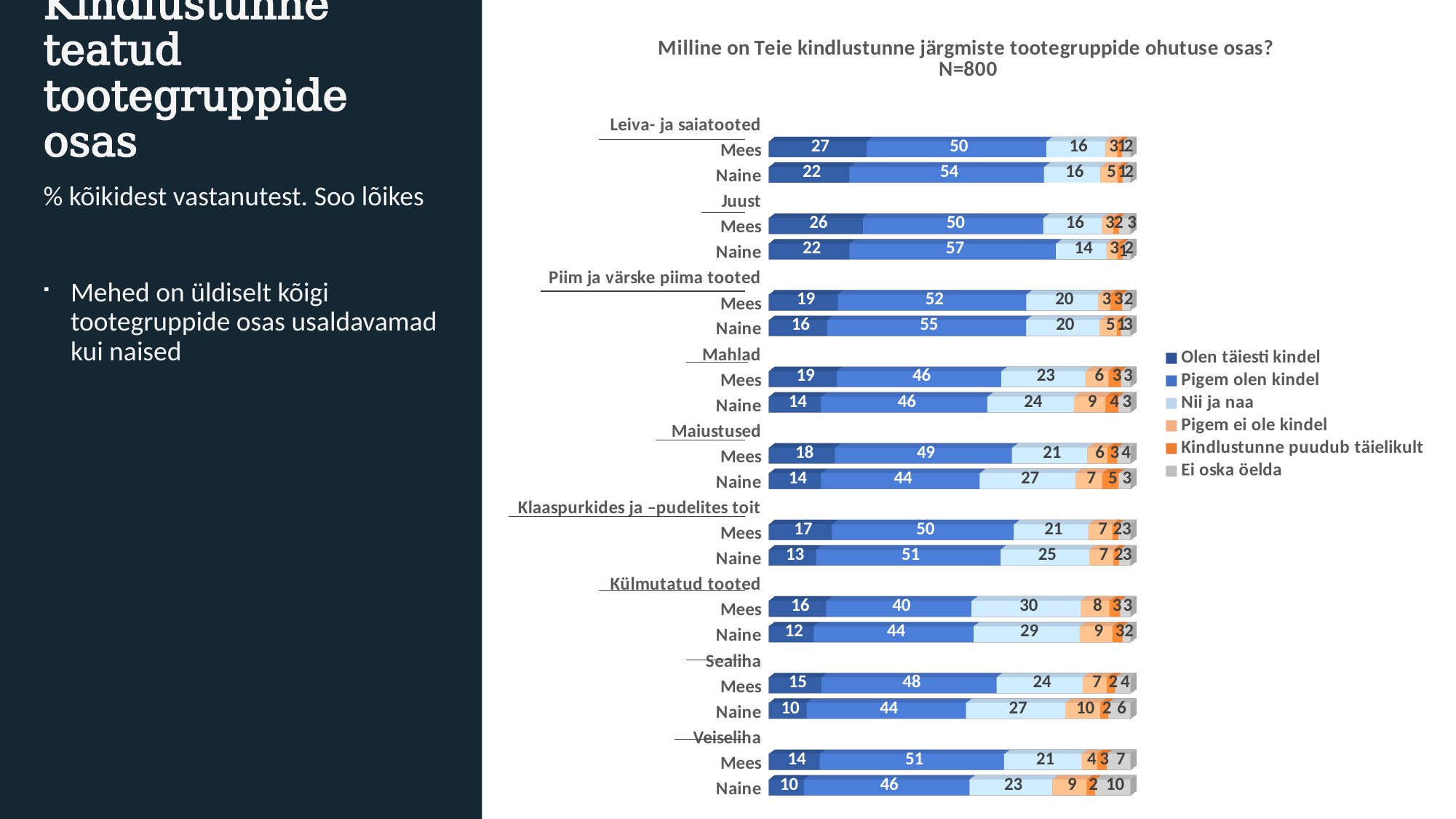
What sample size (N) is stated in the chart title? N=800 What percentage of men (Mees) answered "Olen täiesti kindel" for Leiva- ja saiatooted? 27 For Külmutatud tooted, what is the difference between men's and women's "Olen täiesti kindel" values? 4 What type of chart is shown on the slide? Stacked bar chart Which bar has the highest "Olen täiesti kindel" value? Mees, Leiva- ja saiatooted (27) Which bar has the highest "Nii ja naa" value? Mees, Külmutatud tooted (30) How many response categories does the legend list? 6 What percentage of women (Naine) answered "Pigem olen kindel" for Juust? 57 For Juust, who has the larger "Olen täiesti kindel" value, Mees or Naine? Mees For Piim ja värske piima tooted, who has the larger "Pigem olen kindel" value, Mees or Naine? Naine What percentage of women (Naine) answered "Nii ja naa" for Maiustused? 27 How many product groups are shown in the chart? 9